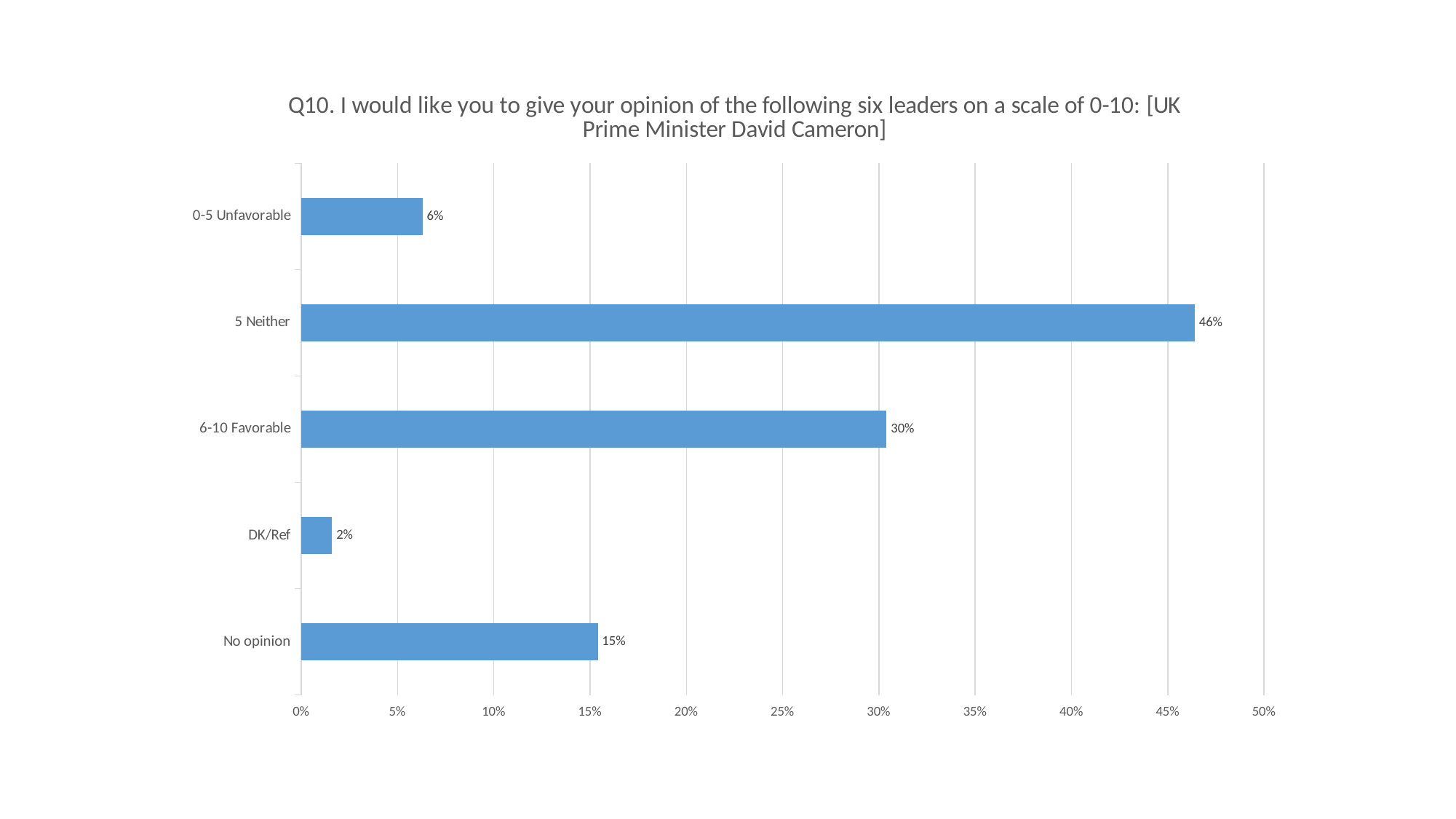
Which leader is named in the chart title? UK Prime Minister David Cameron What is the value for DK/Ref? 2% What is the value for 5 Neither? 46% How many categories are shown in the chart? 5 Which category has the highest value? 5 Neither Which is larger, the value for No opinion or the value for 0-5 Unfavorable? No opinion Which category has the lowest value? DK/Ref What kind of chart is shown on the slide? Bar chart What is the value for 6-10 Favorable? 30% What is the difference between the values for 5 Neither and 6-10 Favorable? 16% What is the value for No opinion? 15% What is the value for 0-5 Unfavorable? 6%